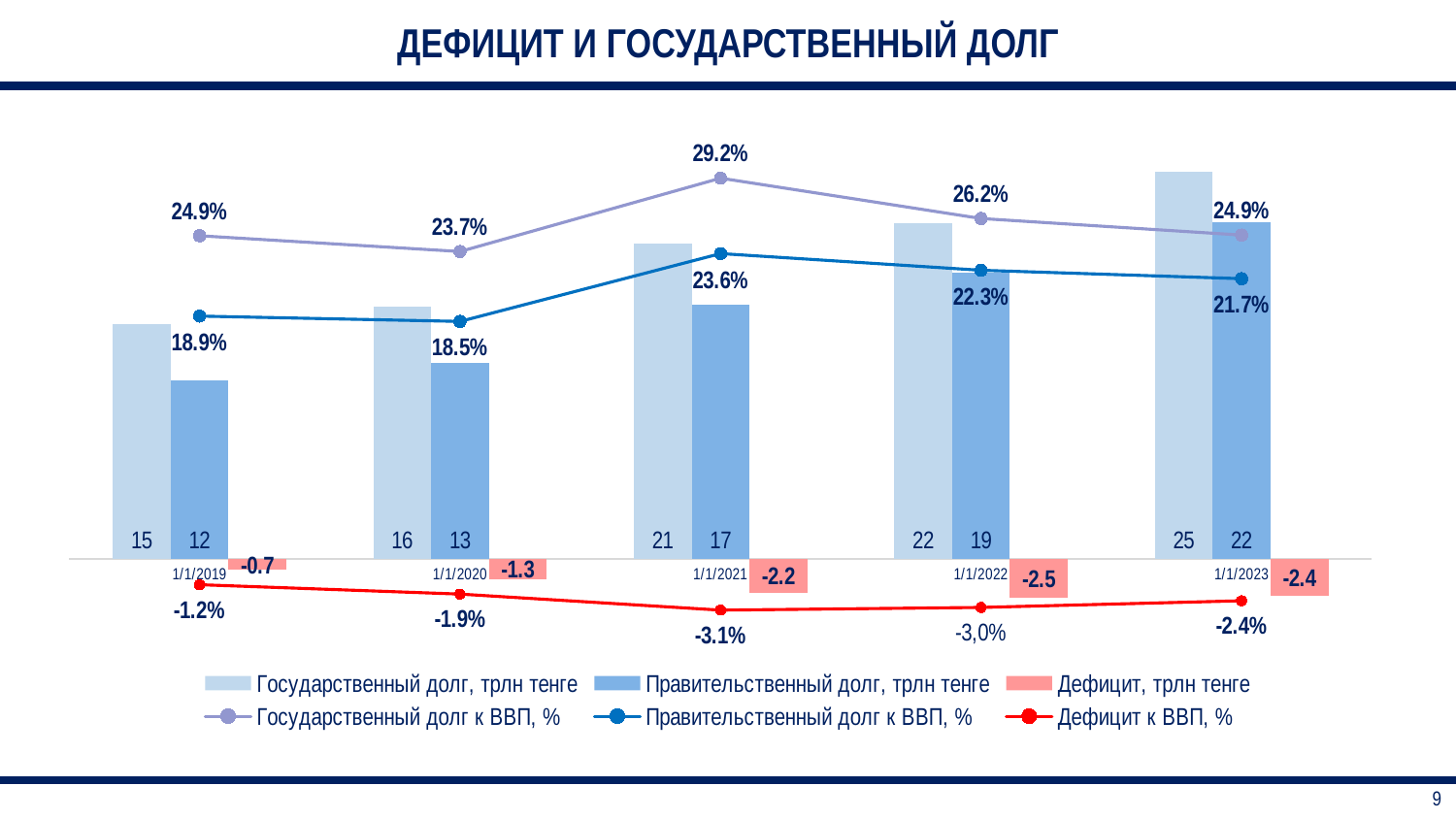
On which date is Государственный долг к ВВП, % the highest? 1/1/2021 Does Государственный долг, трлн тенге rise or fall from 1/1/2019 to 1/1/2023? rise What is the value of Дефицит к ВВП, % on 1/1/2020? -1.9% How many series does the legend list? 6 How many dates are shown on the x axis? 5 On which date is Правительственный долг к ВВП, % the lowest? 1/1/2020 What is the value of Дефицит, трлн тенге on 1/1/2022? -2.5 What is the value of Государственный долг, трлн тенге on 1/1/2023? 25 What is the value of Правительственный долг, трлн тенге on 1/1/2021? 17 What is the difference between Государственный долг, трлн тенге and Правительственный долг, трлн тенге on 1/1/2019? 3 What is the value of Государственный долг к ВВП, % on 1/1/2021? 29.2% Which is larger: Правительственный долг к ВВП, % on 1/1/2021 or on 1/1/2023? 1/1/2021